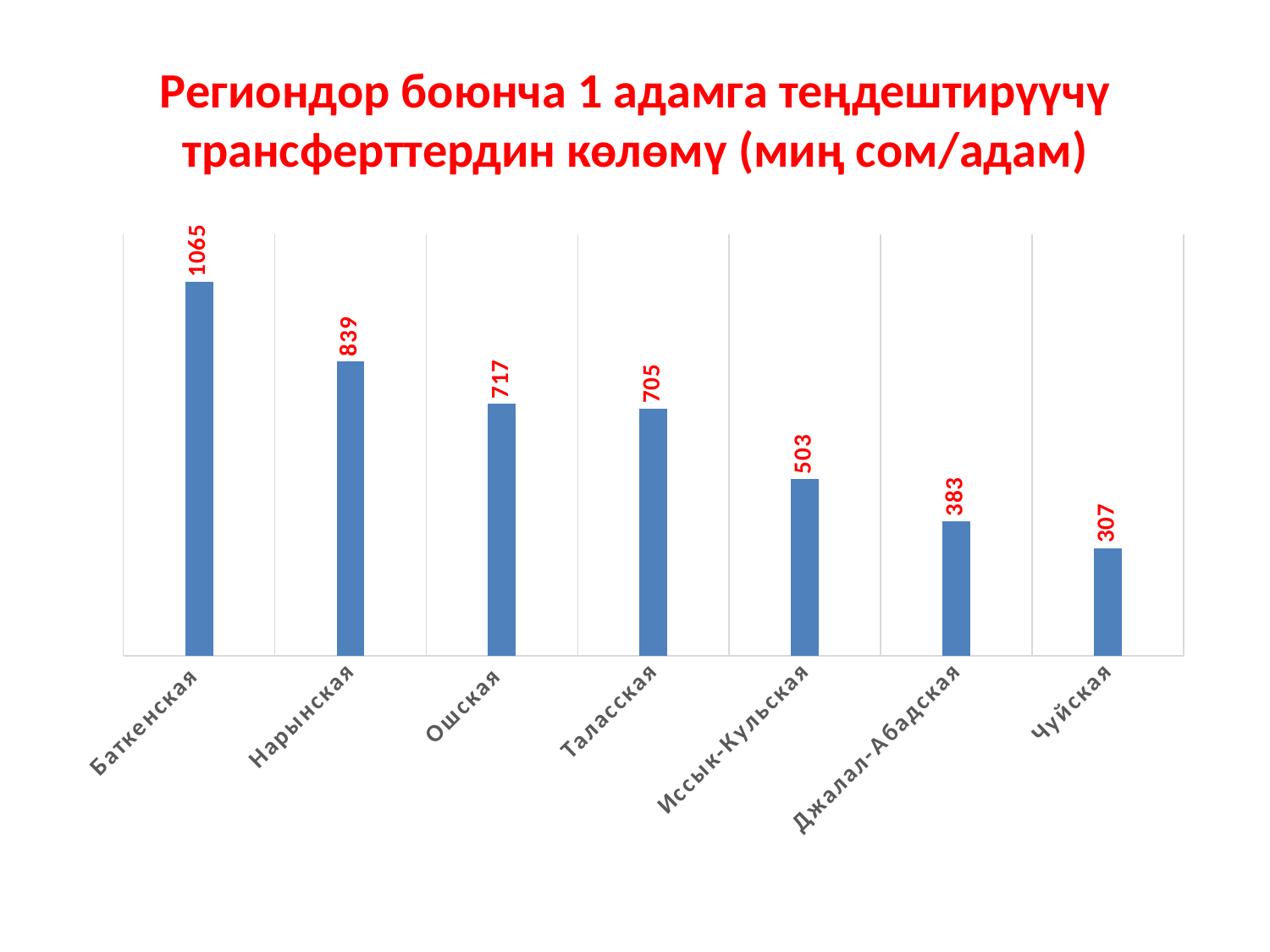
What is the value for Нарынская? 839 Which region has the lowest value? Чуйская What kind of chart is shown on the slide? Bar chart What is the value for Иссык-Кульская? 503 What is the value for Баткенская? 1065 What is the difference between the values for Баткенская and Нарынская? 226 Which region has the highest value? Баткенская Do the values rise or fall from left to right along the x axis? Fall What is the difference between the values for Джалал-Абадская and Чуйская? 76 Which is larger, the value for Ошская or the value for Таласская? Ошская How many regions are shown in the chart? 7 What is the value for Чуйская? 307